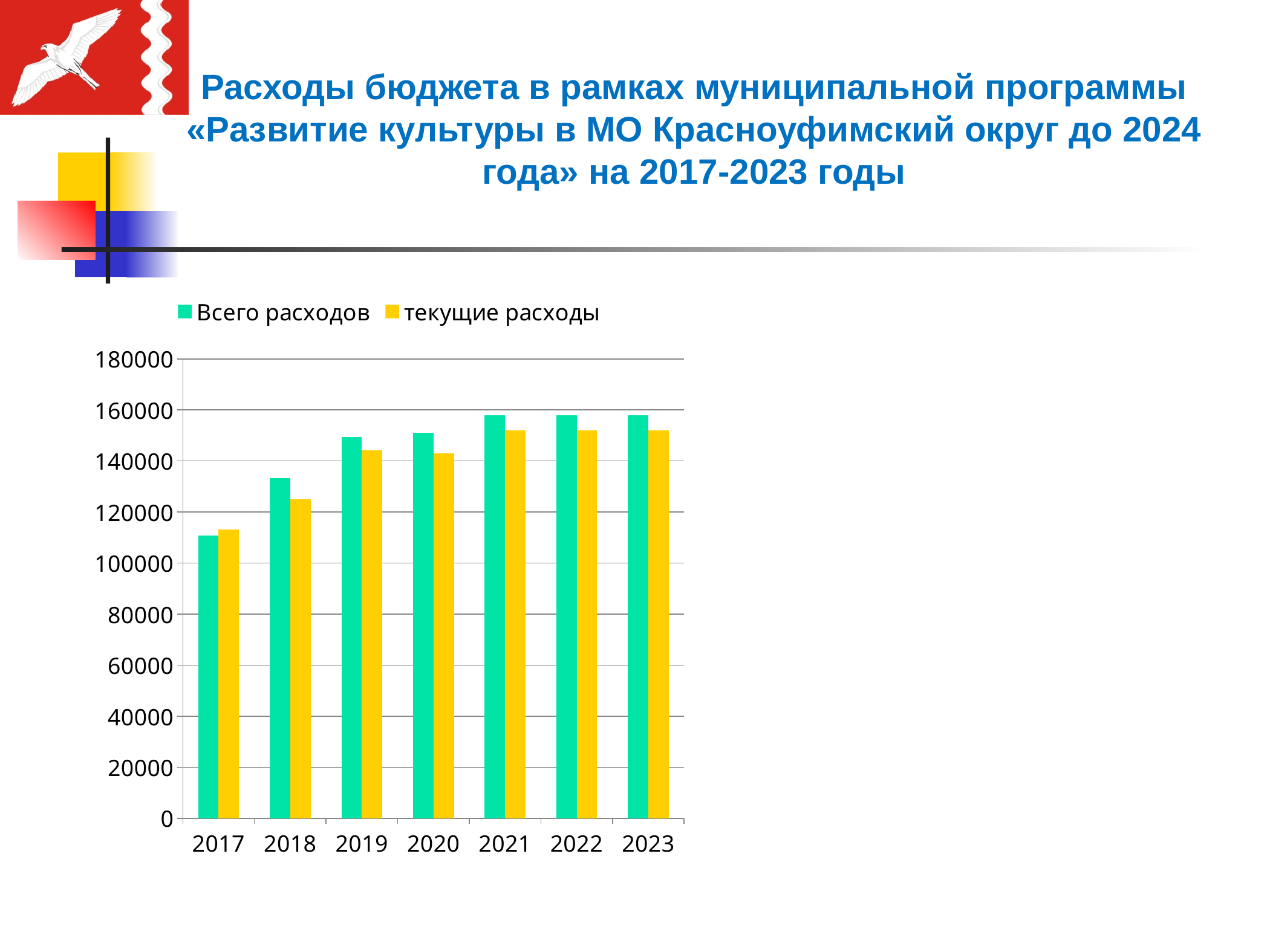
Which year has the lowest value for Всего расходов? 2017 Do the values for Всего расходов generally rise or fall from 2017 to 2021? rise Is the value for Всего расходов in 2017 greater or less than 120000? less Which year has the lowest value for текущие расходы? 2017 Which year has the larger value for Всего расходов: 2017 or 2019? 2019 Is the value for Всего расходов in 2018 greater or less than 120000? greater What kind of chart is shown on the slide? bar chart Is the value for Всего расходов in 2020 greater or less than 140000? greater How many years are shown on the x axis? 7 In 2018, which is larger: Всего расходов or текущие расходы? Всего расходов How many series does the legend list? 2